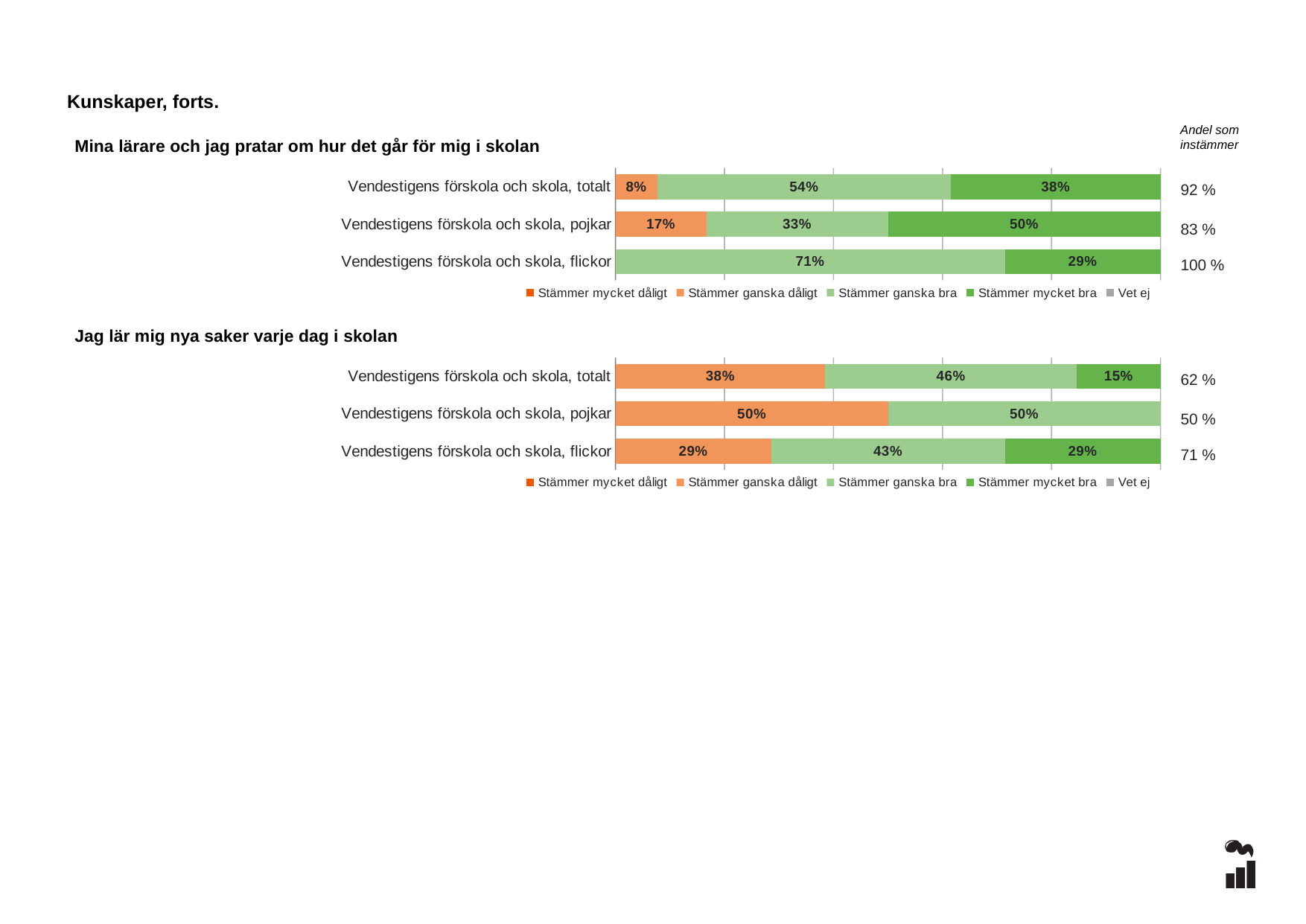
In the chart 'Mina lärare och jag pratar om hur det går för mig i skolan', what is the 'Stämmer ganska bra' value for Vendestigens förskola och skola, flickor? 71% How many series does the legend of the chart 'Jag lär mig nya saker varje dag i skolan' list? 5 What kind of chart is 'Mina lärare och jag pratar om hur det går för mig i skolan'? Stacked bar chart In the chart 'Mina lärare och jag pratar om hur det går för mig i skolan', which is larger: the 'Stämmer ganska bra' value for totalt or for pojkar? totalt In the chart 'Mina lärare och jag pratar om hur det går för mig i skolan', what is the 'Stämmer mycket bra' value for Vendestigens förskola och skola, pojkar? 50% In the chart 'Jag lär mig nya saker varje dag i skolan', which category has the highest 'Stämmer ganska dåligt' value? Vendestigens förskola och skola, pojkar In the chart 'Mina lärare och jag pratar om hur det går för mig i skolan', which category has the lowest 'Stämmer mycket bra' value? Vendestigens förskola och skola, flickor In the chart 'Jag lär mig nya saker varje dag i skolan', what is the 'Andel som instämmer' shown for Vendestigens förskola och skola, flickor? 71 % In the chart 'Jag lär mig nya saker varje dag i skolan', what is the difference between the 'Stämmer ganska bra' values for totalt and flickor? 3% In the chart 'Mina lärare och jag pratar om hur det går för mig i skolan', what is the 'Stämmer ganska dåligt' value for Vendestigens förskola och skola, totalt? 8% In the chart 'Jag lär mig nya saker varje dag i skolan', what is the 'Stämmer mycket bra' value for Vendestigens förskola och skola, totalt? 15% In the chart 'Jag lär mig nya saker varje dag i skolan', what is the 'Stämmer ganska dåligt' value for Vendestigens förskola och skola, pojkar? 50%